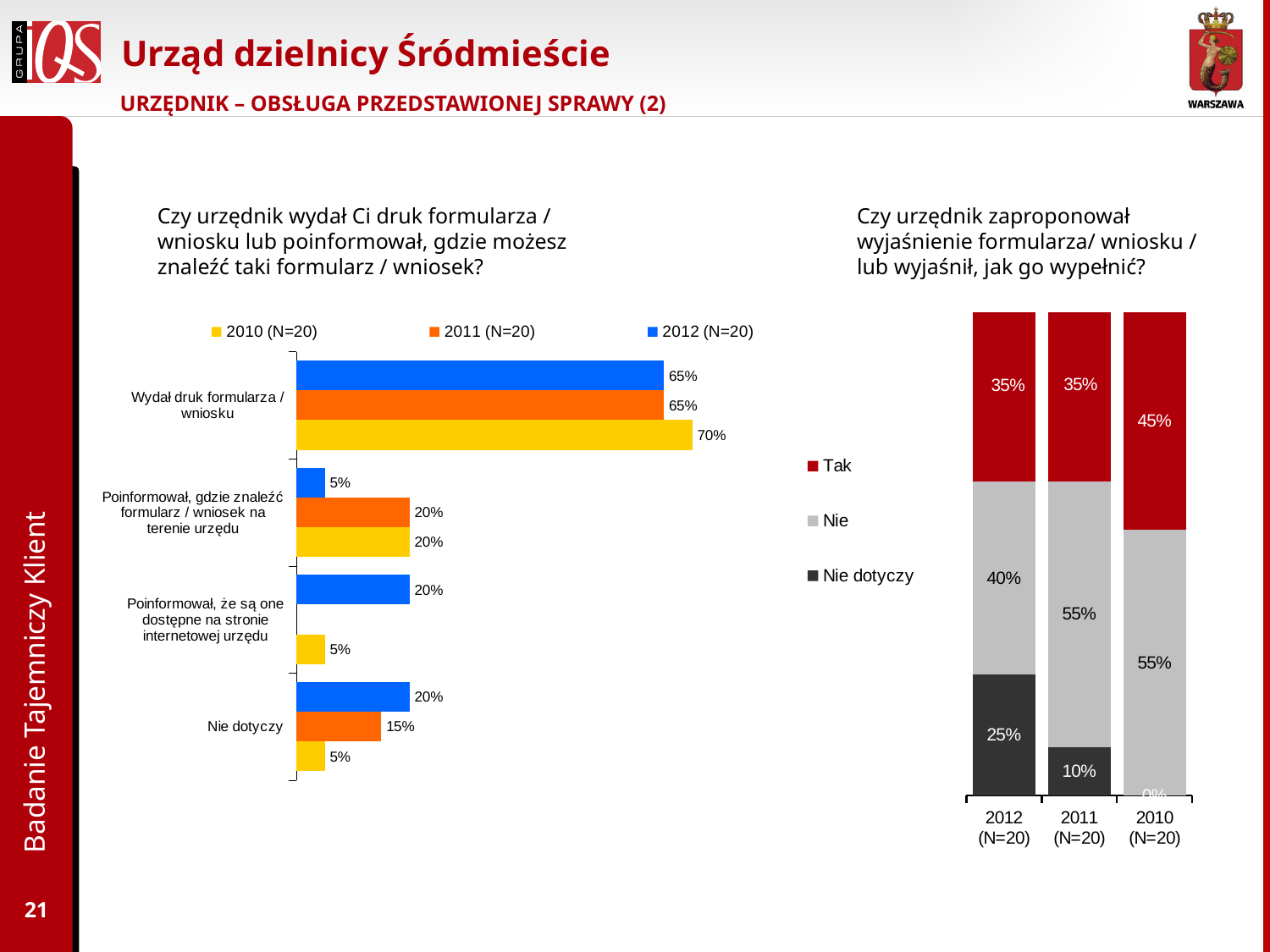
In the right chart, is the 'Nie dotyczy' share for 2012 (N=20) larger or smaller than for 2011 (N=20)? Larger In the right chart, what is the 'Nie dotyczy' share for 2011 (N=20)? 10% In the left chart, what is the difference between the 2010 and 2012 values for 'Wydał druk formularza / wniosku'? 5% In the left chart, which category has the highest 2012 value? Wydał druk formularza / wniosku In the right chart, what is the 'Nie' share for 2012 (N=20)? 40% In the left chart, what is the 2010 value for 'Wydał druk formularza / wniosku'? 70% In the left chart, how many categories are shown? 4 What kind of chart is the left chart? Bar chart In the right chart, which year has the highest 'Tak' share? 2010 (N=20) In the left chart, what is the 2011 value for 'Nie dotyczy'? 15% In the left chart, how many series does the legend list? 3 In the left chart, what is the 2012 value for 'Poinformował, gdzie znaleźć formularz / wniosek na terenie urzędu'? 5%